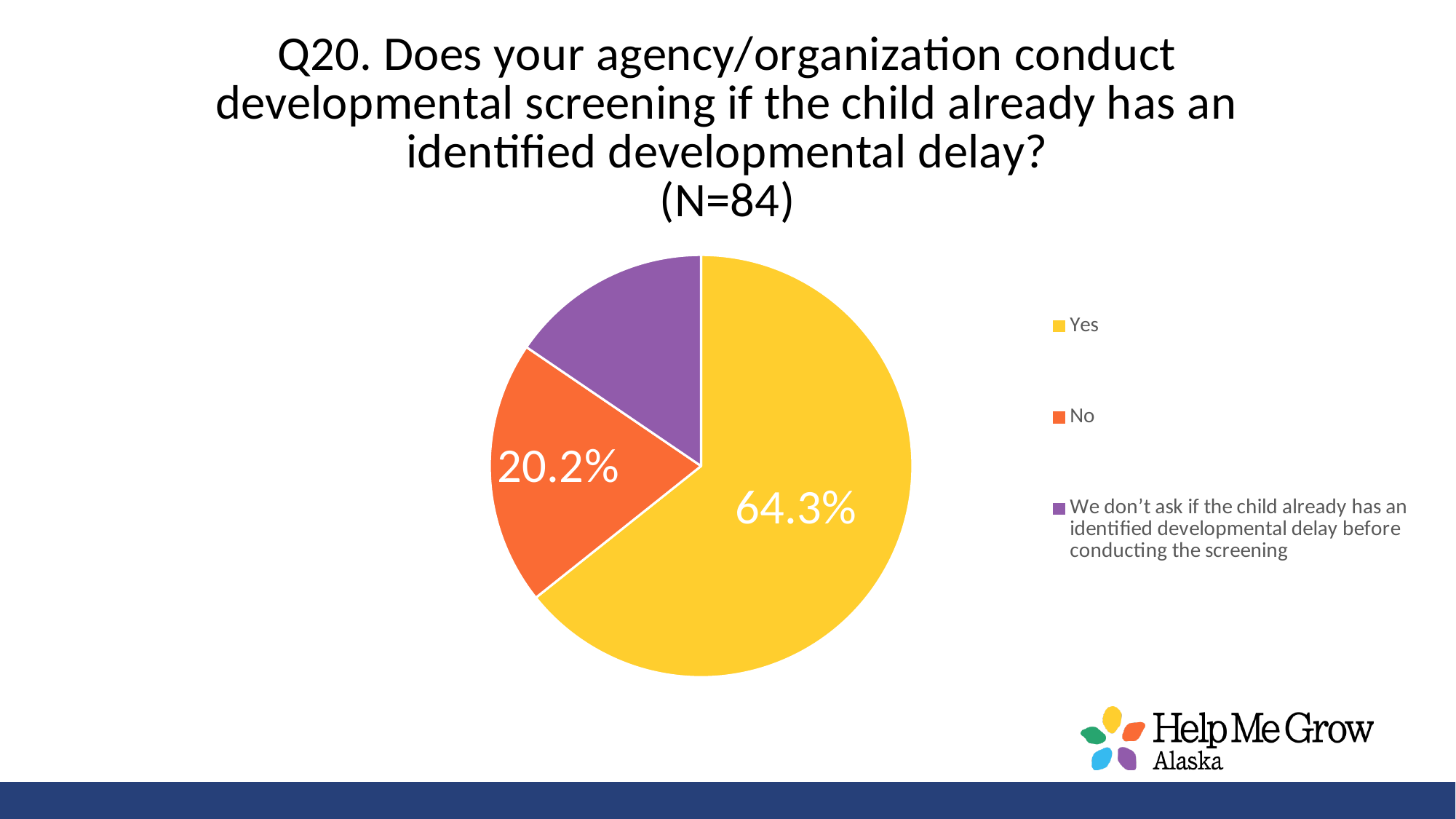
What percentage of respondents answered "Yes"? 64.3% How many entries does the legend list? 3 Which response has the largest share of the pie? Yes Which response has the smallest share of the pie? We don't ask if the child already has an identified developmental delay before conducting the screening What colour is the "Yes" slice? yellow Is the "No" slice larger or smaller than the purple "We don't ask..." slice? larger Which slice is larger, "Yes" or "No"? Yes How many slices does the pie chart have? 3 What is the difference in percentage points between the "Yes" and "No" slices? 44.1 What type of chart is shown on the slide? pie chart What percentage of respondents answered "No"? 20.2% What is the sample size (N) stated in the chart title? 84